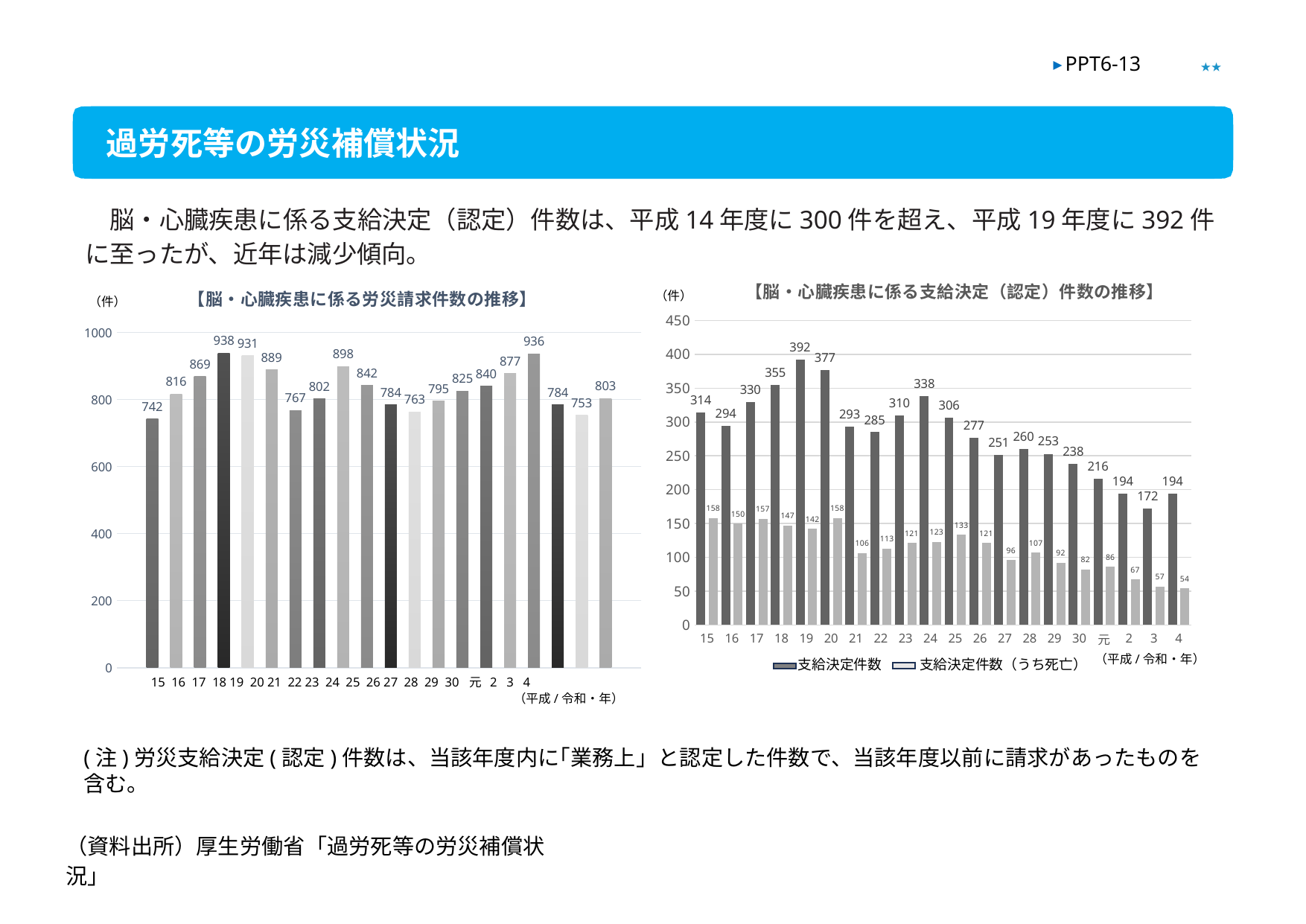
In the right chart (支給決定（認定）件数の推移), what is the difference between the 支給決定件数 for 平成19年 and 令和3年? 220 In the left chart (労災請求件数の推移), what is the difference between the values for 平成18年 and 平成15年? 196 In the right chart (支給決定（認定）件数の推移), what is the 支給決定件数（うち死亡） value for 令和4年? 54 In the right chart (支給決定（認定）件数の推移), which year has the highest 支給決定件数? 平成19年 (392) In the right chart (支給決定（認定）件数の推移), how many series does the legend list? 2 In the left chart (労災請求件数の推移), which year has the lowest value? 平成15年 (742) In the right chart (支給決定（認定）件数の推移), which is larger, the 支給決定件数 for 平成24年 or for 平成25年? 平成24年 (338) In the left chart (労災請求件数の推移), what is the value for 平成18年? 938 In the left chart (労災請求件数の推移), how many years are plotted? 20 In the right chart (支給決定（認定）件数の推移), does the 支給決定件数 generally rise or fall from 平成24年 to 令和3年? Fall What kind of chart is the right chart (支給決定（認定）件数の推移)? Bar chart In the right chart (支給決定（認定）件数の推移), what is the 支給決定件数 value for 平成19年? 392